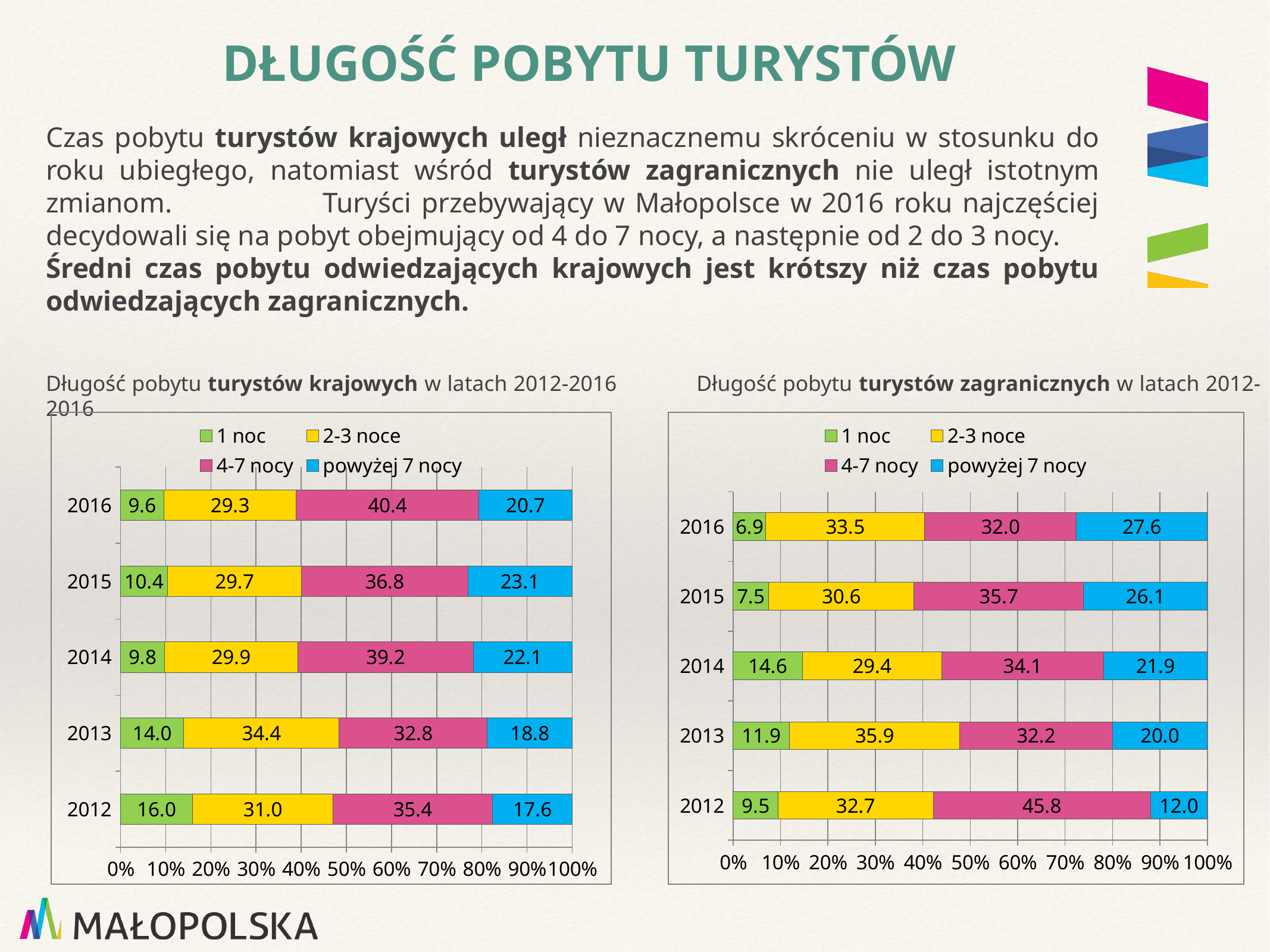
In the left chart (turystów krajowych), does the '1 noc' value rise or fall from 2012 to 2016? Fall In the right chart (Długość pobytu turystów zagranicznych), what is the value for 'powyżej 7 nocy' in 2012? 12.0 In the left chart (turystów krajowych), which colour represents 'powyżej 7 nocy'? Blue In the right chart (turystów zagranicznych), what is the total of the 2015 bar? 99.9 What kind of chart is the left chart (turystów krajowych)? Stacked bar chart In the right chart (turystów zagranicznych), what is the difference between the '4-7 nocy' values for 2012 and 2016? 13.8 In the left chart (turystów krajowych), which is larger: the '2-3 noce' value for 2013 or for 2016? 2013 In the left chart (Długość pobytu turystów krajowych), what is the value for '4-7 nocy' in 2016? 40.4 How many series does the legend of the right chart (turystów zagranicznych) list? 4 In the left chart (turystów krajowych), which year has the highest value for '1 noc'? 2012 In the right chart (turystów zagranicznych), which year has the lowest value for '1 noc'? 2016 How many years are shown in the left chart (turystów krajowych)? 5